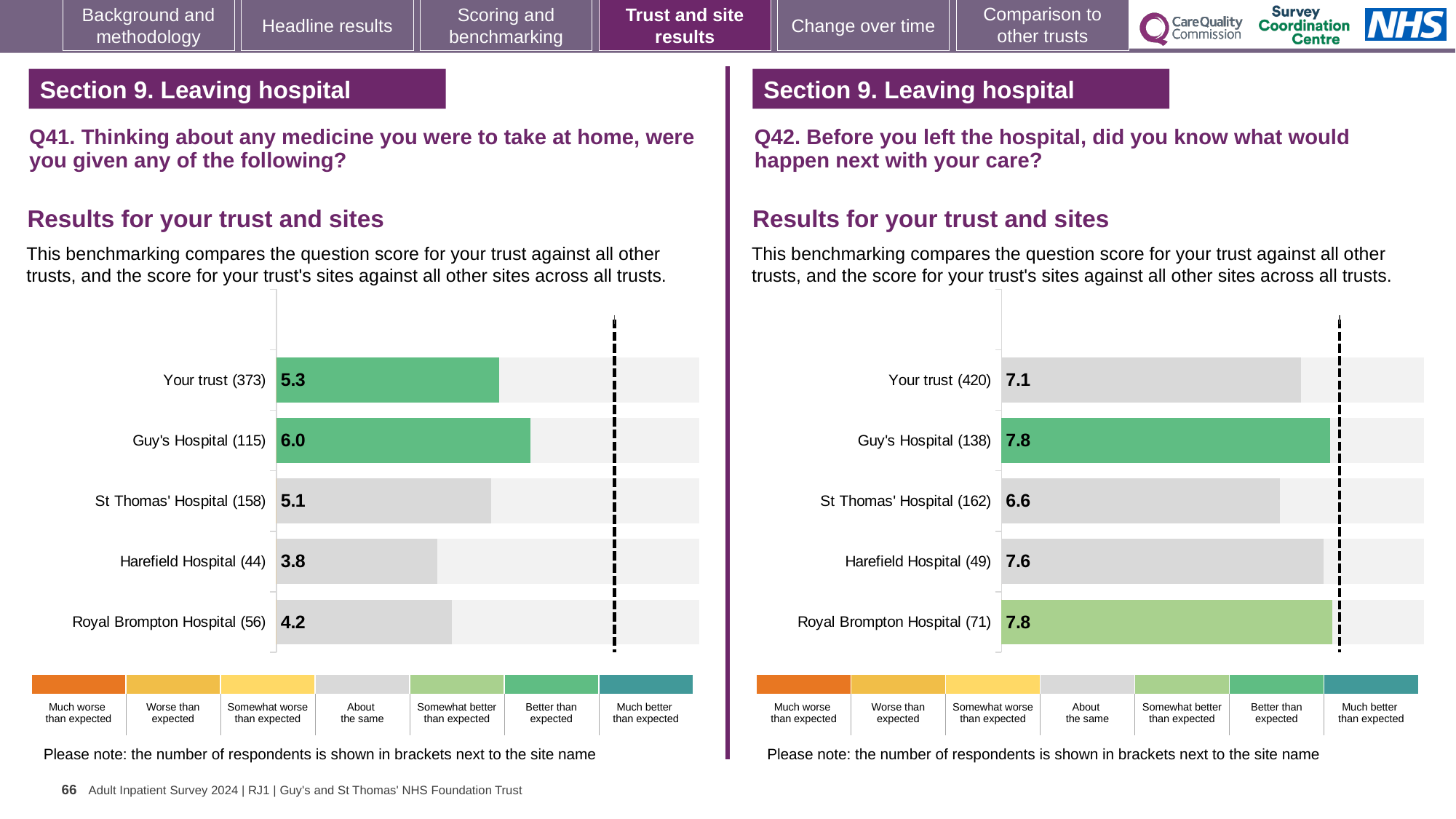
In the Q41 chart on the left, what is the difference between the scores for Guy's Hospital and Royal Brompton Hospital? 1.8 In the Q42 chart on the right, what is the score for Your trust? 7.1 How many bars are shown in the Q41 chart on the left? 5 In the Q42 chart on the right, which is larger: the score for Harefield Hospital or the score for St Thomas' Hospital? Harefield Hospital What type of chart is used for the Q42 results on the right? Bar chart In the Q42 chart on the right, which site has the lowest score? St Thomas' Hospital In the Q41 chart on the left, what is the score for Harefield Hospital? 3.8 In the Q41 chart on the left, which site has the lowest score? Harefield Hospital In the Q41 chart on the left, what is the score for Guy's Hospital? 6.0 In the Q42 chart on the right, what is the score for St Thomas' Hospital? 6.6 In the Q42 chart on the right, what is the difference between the scores for Guy's Hospital and Your trust? 0.7 In the Q41 chart on the left, which bar has the highest score? Guy's Hospital